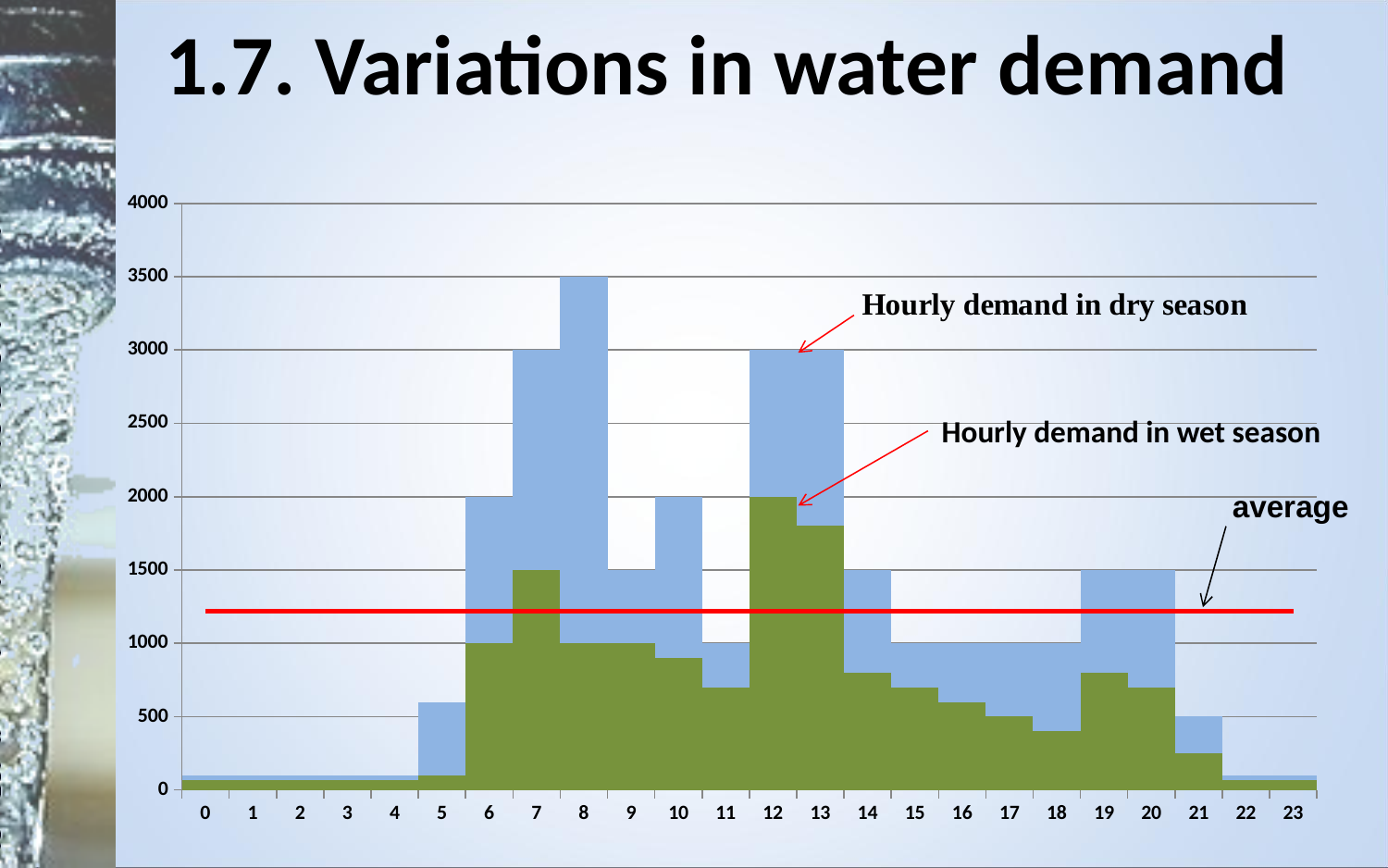
How many hours are shown on the x axis? 24 At which hour is the hourly demand in wet season highest? 12 What kind of chart is shown on the slide? bar chart What is the hourly demand in dry season at hour 7? 3000 What is the hourly demand in wet season at hour 12? 2000 Is the hourly demand in dry season at hour 5 greater or less than 1000? less At which hour is the hourly demand in dry season highest? 8 What is the hourly demand in dry season at hour 8? 3500 What does the red horizontal line on the chart represent? average Is the hourly demand in wet season at hour 13 greater or less than 1500? greater Which is larger, the hourly demand in dry season at hour 8 or at hour 12? hour 8 Does the hourly demand in dry season rise or fall from hour 13 to hour 18? fall